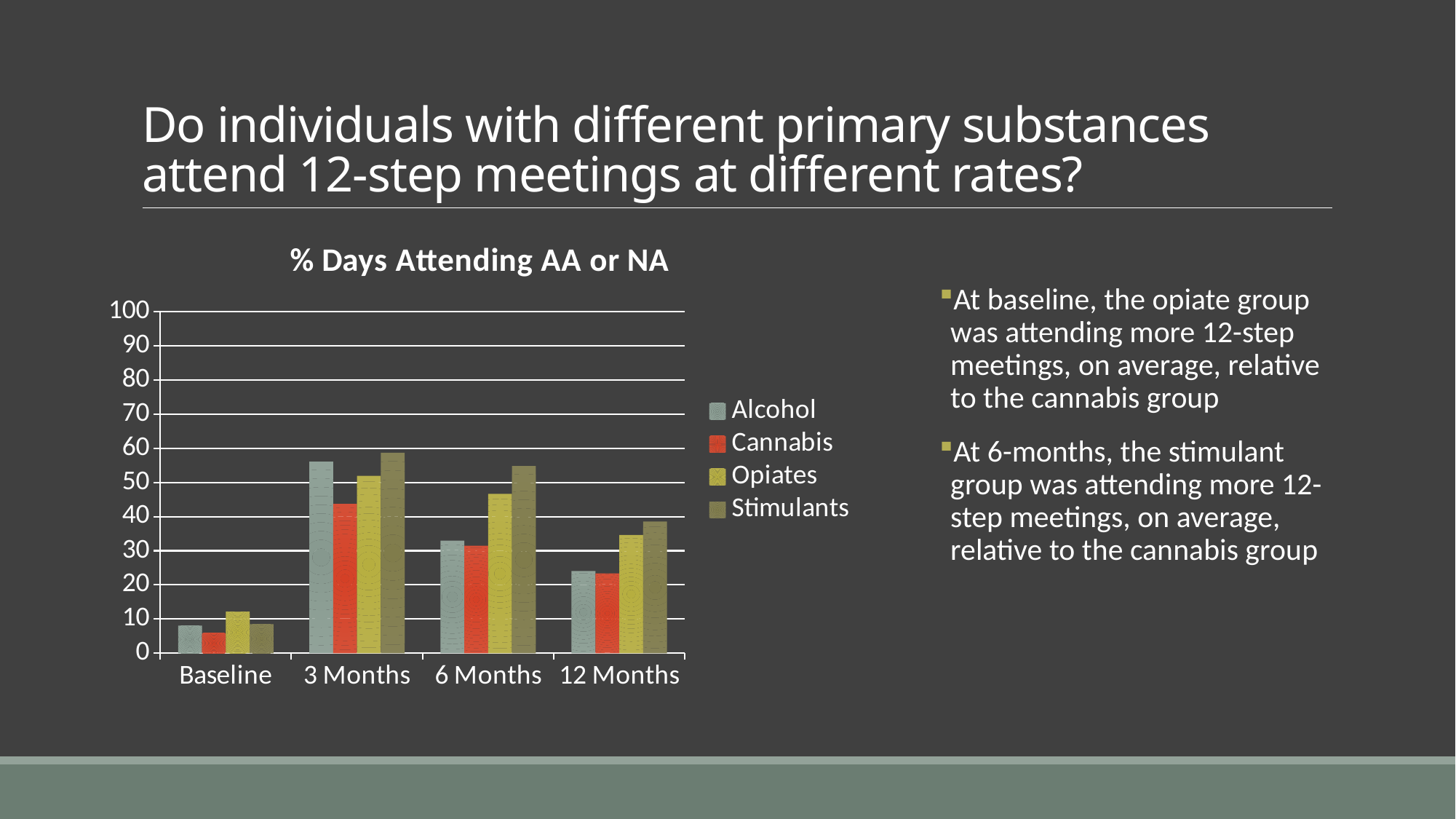
Do the values for Stimulants rise or fall from 3 Months to 12 Months? Fall Is the value for Cannabis at Baseline greater or less than 10? less How many time-point categories are shown on the x axis of the chart? 4 What is the title of the chart? % Days Attending AA or NA How many series does the chart legend list? 4 At 6 Months, which substance group has the highest % days attending AA or NA? Stimulants Is the value for Opiates at 6 Months greater or less than 40? greater What kind of chart is shown on the slide? Bar chart At Baseline, which substance group has the highest % days attending AA or NA? Opiates At 3 Months, which is larger: the value for Alcohol or the value for Cannabis? Alcohol At Baseline, which substance group has the lowest % days attending AA or NA? Cannabis Is the value for Stimulants at 3 Months greater or less than 50? greater